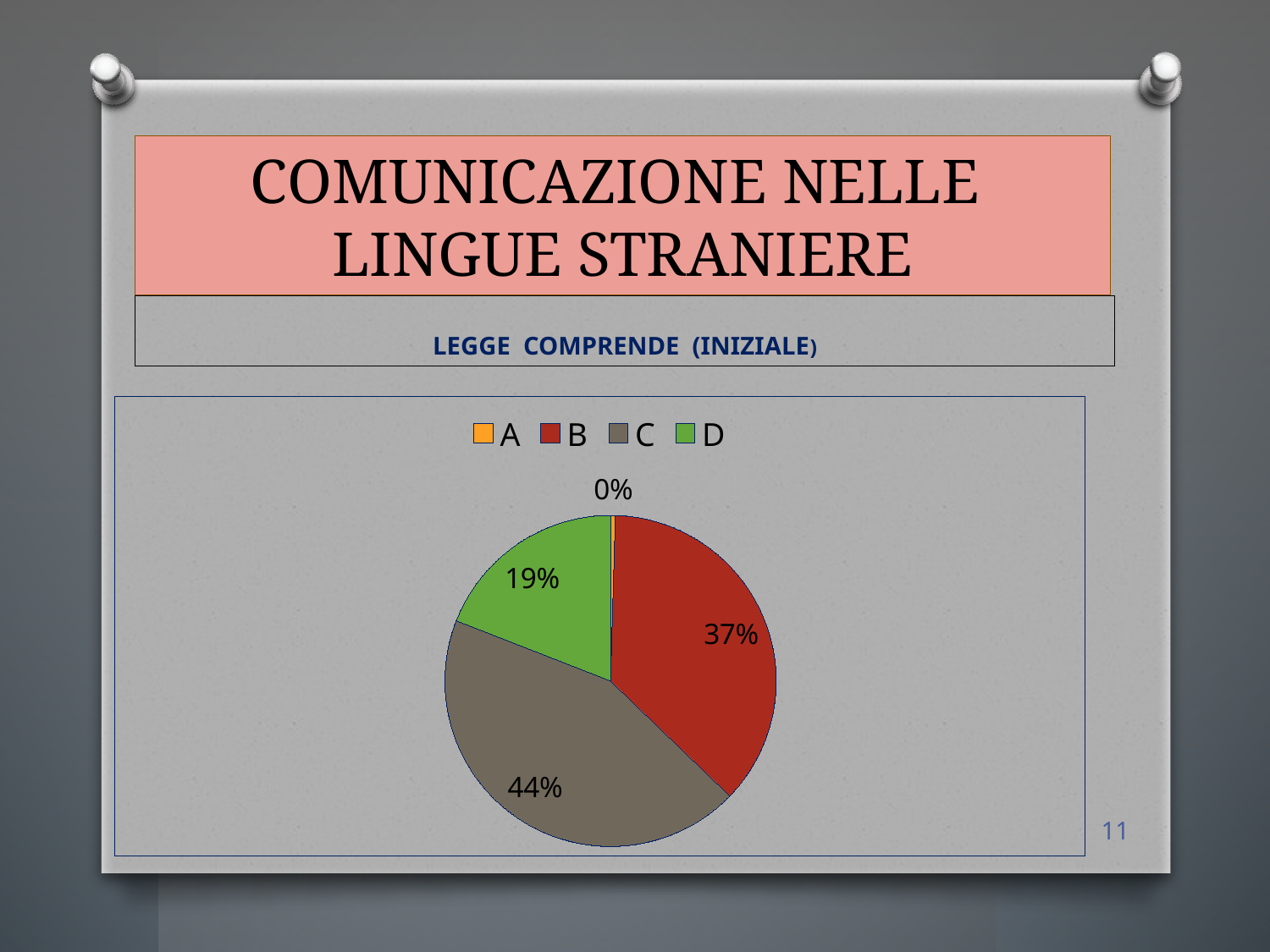
What colour is slice C in the pie chart? grey What kind of chart is shown on the slide? pie chart What percentage does slice D represent in the pie chart? 19% What percentage does slice B represent in the pie chart? 37% Which category has the smallest share of the pie chart? A How many categories does the legend of the pie chart list? 4 What percentage does slice C represent in the pie chart? 44% Which is larger, the share for B or the share for D? B Which category has the largest share of the pie chart? C What percentage does slice A represent in the pie chart? 0% What is the difference in percentage points between slice C and slice B? 7 What is the subtitle shown above the pie chart? LEGGE COMPRENDE (INIZIALE)